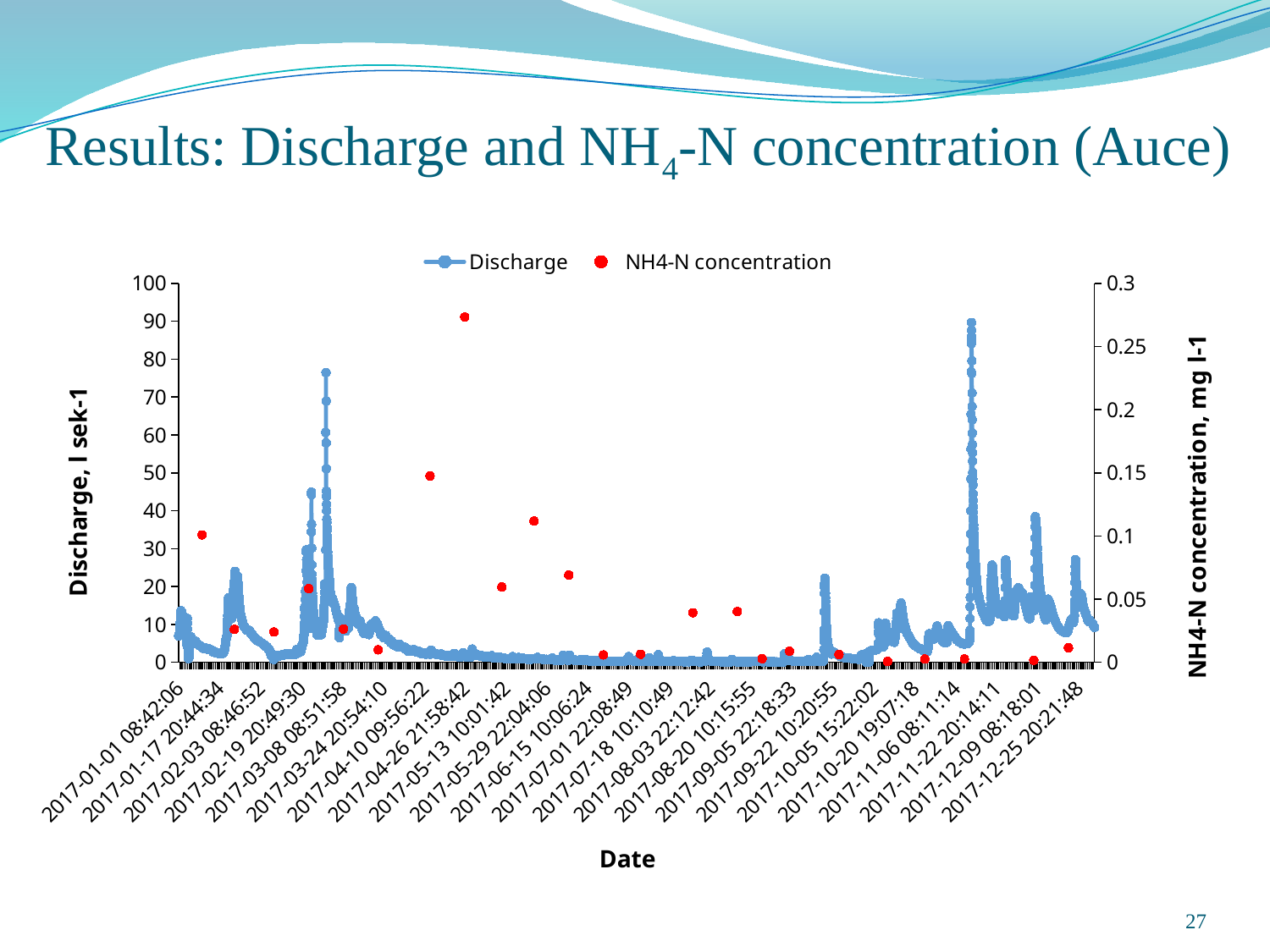
Is the highest NH4-N concentration value on the chart greater or less than 0.25? greater Around which x-axis date does the NH4-N concentration series reach its highest value? 2017-05-13 10:01:42 What is the title of the left vertical axis? Discharge, l sek-1 How many series does the legend list? 2 Is the Discharge peak near 2017-03-08 08:51:58 greater or less than 70? greater Is the NH4-N concentration value near 2017-01-01 greater or less than 0.15? less Which Discharge peak is higher: the one near 2017-03-08 or the one near 2017-11-22? 2017-11-22 What are the two series named in the legend? Discharge and NH4-N concentration What is the maximum value shown on the right vertical axis (NH4-N concentration)? 0.3 Around which x-axis date does the Discharge series reach its highest peak? 2017-11-22 20:14:11 What kind of chart is shown on the slide? line chart